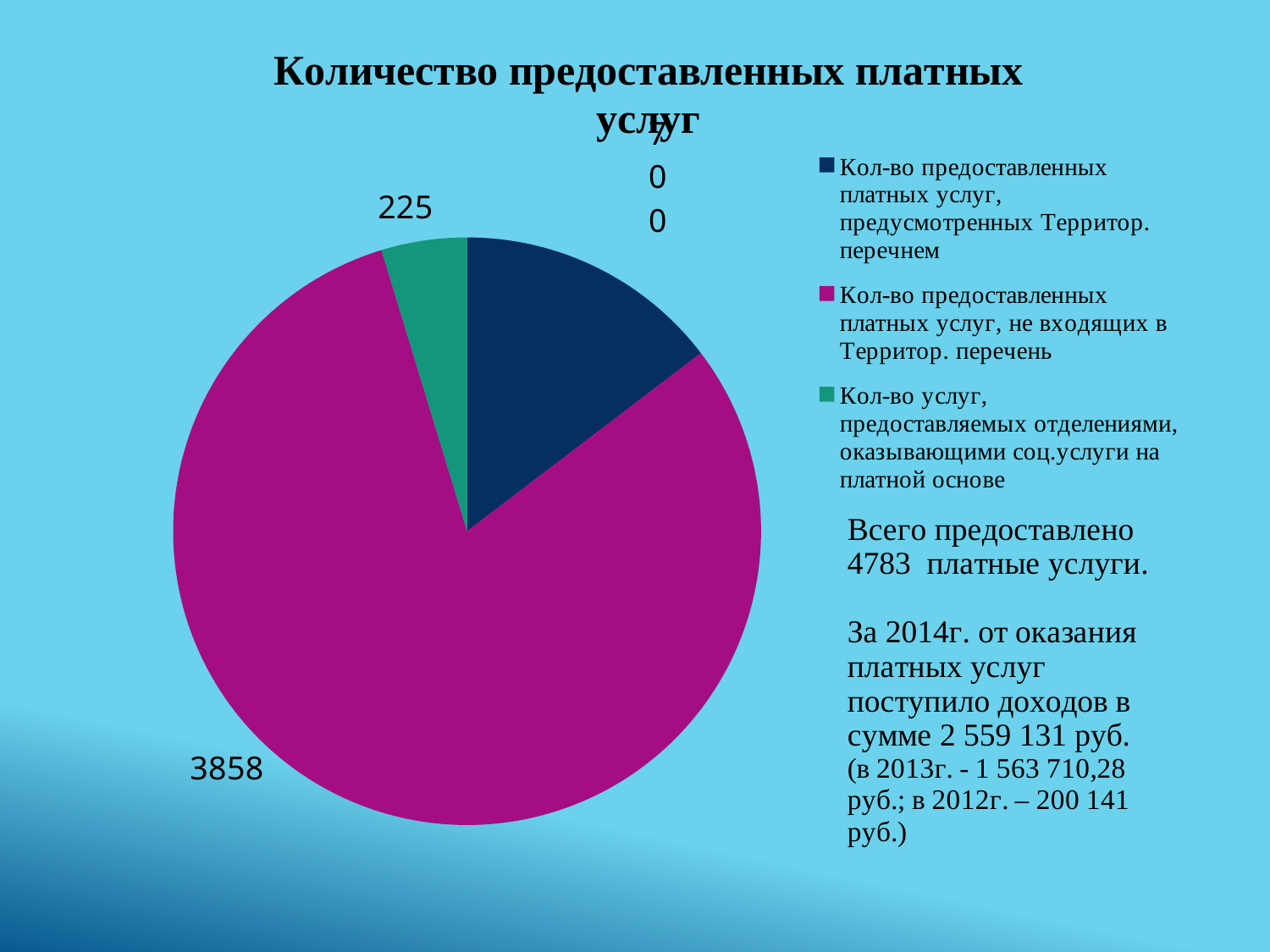
What kind of chart is shown on the slide? pie chart What is the difference between the value 3858 and the value 225 shown on the pie? 3633 What is the title of the chart? Количество предоставленных платных услуг How many slices does the pie chart have? 3 What is the value for 'Кол-во услуг, предоставляемых отделениями, оказывающими соц.услуги на платной основе'? 225 Which is larger: the slice for services not included in the Territorial list (не входящих в Территор. перечень) or the slice for services provided by departments on a paid basis (предоставляемых отделениями)? не входящих в Территор. перечень Which category has the largest slice of the pie? Кол-во предоставленных платных услуг, не входящих в Территор. перечень Which category has the smallest slice of the pie? Кол-во услуг, предоставляемых отделениями, оказывающими соц.услуги на платной основе What colour is the largest slice of the pie? magenta What is the value for 'Кол-во предоставленных платных услуг, не входящих в Территор. перечень'? 3858 How many entries does the legend list? 3